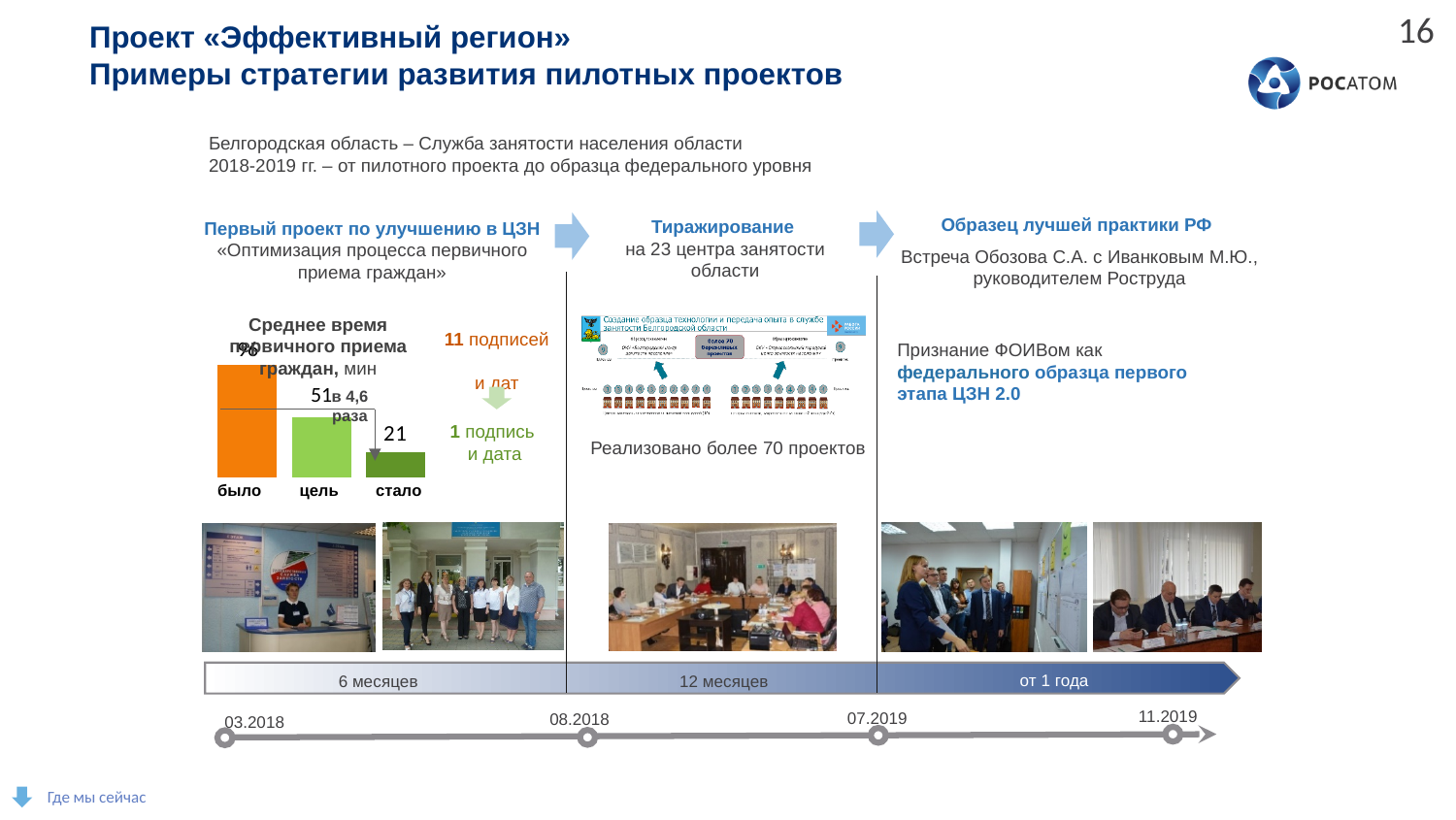
In the bar chart «Среднее время первичного приема граждан, мин», which category has the lowest value? стало In the bar chart «Среднее время первичного приема граждан, мин», what is the difference between the values for «цель» and «стало»? 30 In the bar chart «Среднее время первичного приема граждан, мин», what is the value for «было»? 96 In the bar chart «Среднее время первичного приема граждан, мин», how many categories are plotted? 3 What kind of chart is shown under the heading «Среднее время первичного приема граждан, мин»? bar chart In the bar chart «Среднее время первичного приема граждан, мин», do the values rise or fall from «было» to «стало»? fall In the bar chart «Среднее время первичного приема граждан, мин», which is larger: the value for «цель» or the value for «стало»? цель In the bar chart «Среднее время первичного приема граждан, мин», what colour is the bar for «было»? orange In the bar chart «Среднее время первичного приема граждан, мин», which category has the highest value? было In the bar chart «Среднее время первичного приема граждан, мин», what is the value for «цель»? 51 In the bar chart «Среднее время первичного приема граждан, мин», what unit is stated in the chart title? мин In the bar chart «Среднее время первичного приема граждан, мин», what is the value for «стало»? 21